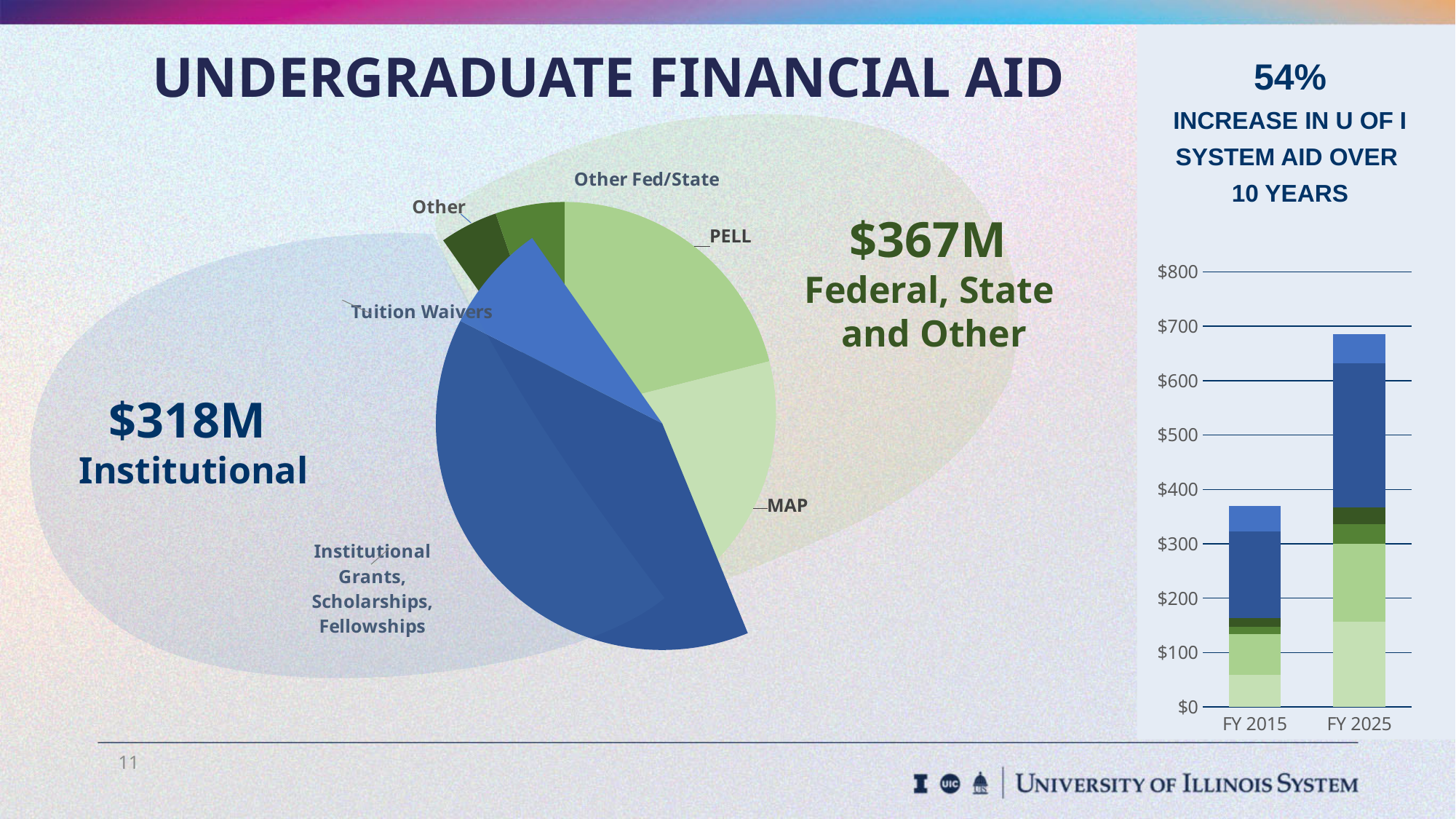
In the pie chart, which slice is larger, PELL or MAP? MAP What kind of chart is the chart on the right of the slide? bar chart What is the title of the slide? UNDERGRADUATE FINANCIAL AID How many slices does the pie chart have? 6 What kind of chart is the chart in the centre of the slide? pie chart Which slice of the pie chart is the largest? Institutional Grants, Scholarships, Fellowships In the bar chart on the right, is the total for FY 2025 greater or less than $600? greater In the bar chart on the right, which bar is taller, FY 2015 or FY 2025? FY 2025 In the pie chart, which slice is larger, Tuition Waivers or Other? Tuition Waivers In the bar chart on the right, do the totals rise or fall from FY 2015 to FY 2025? rise How many categories are shown on the x axis of the bar chart on the right? 2 In the bar chart on the right, is the total for FY 2015 greater or less than $400? less